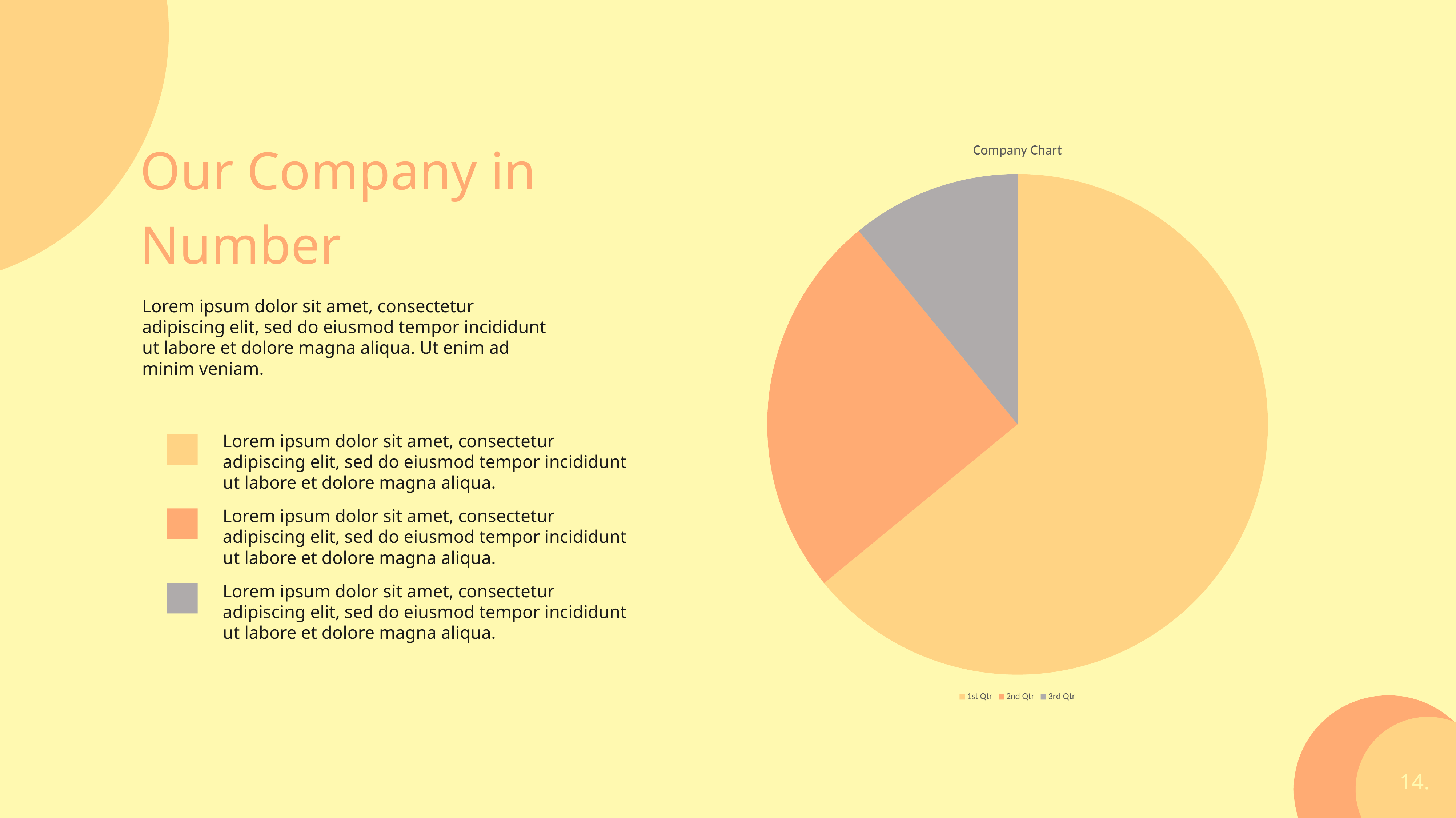
What kind of chart is shown on the slide? pie chart Which slice is larger, 2nd Qtr or 3rd Qtr? 2nd Qtr Which category has the largest slice of the pie chart? 1st Qtr How many slices does the pie chart have? 3 How many entries does the chart legend list? 3 Does the 1st Qtr slice take up more or less than half of the pie? more Which category has the smallest slice of the pie chart? 3rd Qtr What is the title of the chart? Company Chart Which slice is larger, 1st Qtr or 2nd Qtr? 1st Qtr What colour is the 3rd Qtr slice in the pie chart? gray